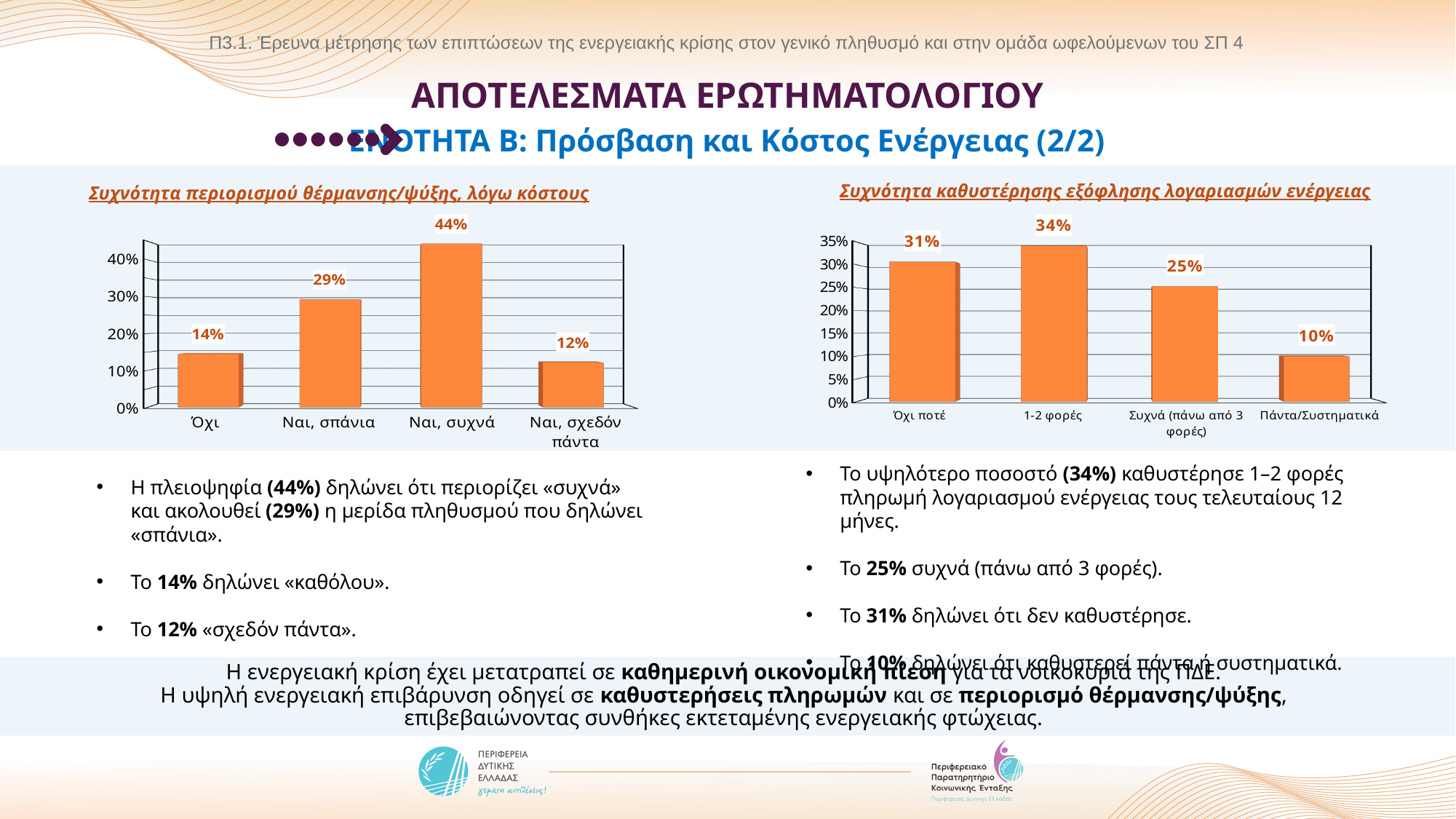
In the right chart (Συχνότητα καθυστέρησης εξόφλησης λογαριασμών ενέργειας), which category has the highest value? 1-2 φορές In the right chart (Συχνότητα καθυστέρησης εξόφλησης λογαριασμών ενέργειας), which is larger: «Όχι ποτέ» or «Συχνά (πάνω από 3 φορές)»? Όχι ποτέ In the left chart (Συχνότητα περιορισμού θέρμανσης/ψύξης, λόγω κόστους), what is the value for «Ναι, συχνά»? 44% In the right chart (Συχνότητα καθυστέρησης εξόφλησης λογαριασμών ενέργειας), what is the difference between «Όχι ποτέ» and «Πάντα/Συστηματικά»? 21% In the left chart (Συχνότητα περιορισμού θέρμανσης/ψύξης, λόγω κόστους), what is the value for «Όχι»? 14% In the right chart (Συχνότητα καθυστέρησης εξόφλησης λογαριασμών ενέργειας), what is the value for «Πάντα/Συστηματικά»? 10% In the right chart (Συχνότητα καθυστέρησης εξόφλησης λογαριασμών ενέργειας), what is the value for «1-2 φορές»? 34% In the left chart (Συχνότητα περιορισμού θέρμανσης/ψύξης, λόγω κόστους), what is the difference between «Ναι, συχνά» and «Ναι, σπάνια»? 15% What colour are the bars in the left chart (Συχνότητα περιορισμού θέρμανσης/ψύξης, λόγω κόστους)? Orange In the left chart (Συχνότητα περιορισμού θέρμανσης/ψύξης, λόγω κόστους), how many categories are shown? 4 What kind of chart is the right chart (Συχνότητα καθυστέρησης εξόφλησης λογαριασμών ενέργειας)? Bar chart In the left chart (Συχνότητα περιορισμού θέρμανσης/ψύξης, λόγω κόστους), which category has the lowest value? Ναι, σχεδόν πάντα